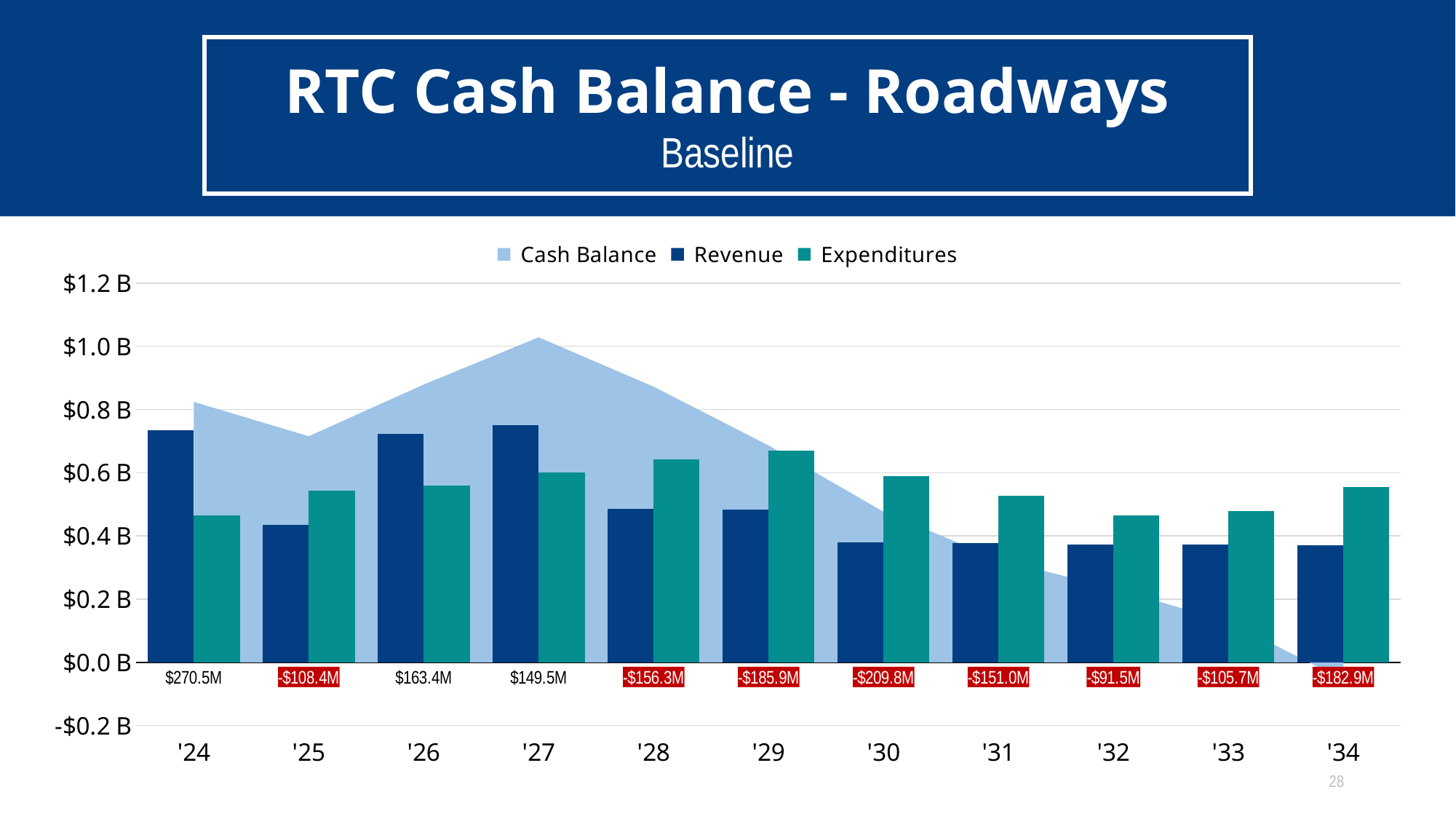
In '30, which is larger, Revenue or Expenditures? Expenditures How many years are shown on the x axis? 11 Is the Expenditures value for '24 greater or less than $0.6 B? less Which year has the highest value among the labels printed below the x axis? '24 What value is printed below the '30 category? -$209.8M In '24, which is larger, Revenue or Expenditures? Revenue What is the difference between the values printed below '24 and '26? $107.1M What value is printed below the '24 category? $270.5M How many series does the legend list? 3 Is the Revenue value for '24 greater or less than $0.6 B? greater What value is printed below the '34 category? -$182.9M Which year has the lowest value among the labels printed below the x axis? '30